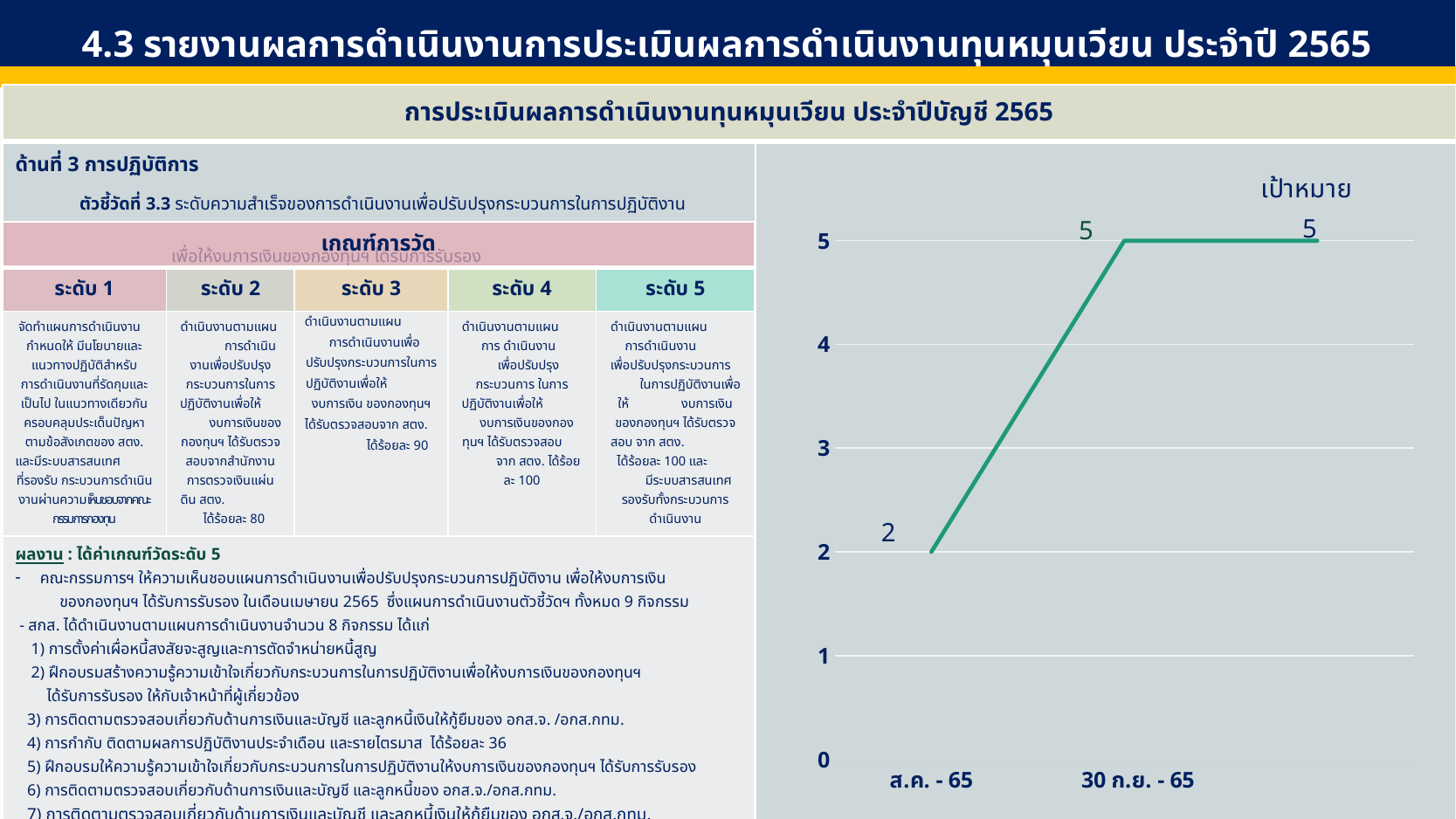
What value is plotted for 30 ก.ย. - 65 on the line chart? 5 Is the value for ส.ค. - 65 greater or less than 3? less What is the highest value plotted on the line chart? 5 What is the highest tick value shown on the y axis of the line chart? 5 What value is shown for เป้าหมาย (the target) on the line chart? 5 How many data points are plotted on the line chart? 3 Does the line rise or fall from ส.ค. - 65 to 30 ก.ย. - 65? rise What kind of chart is shown on the right side of the slide? line chart Which has the larger value, ส.ค. - 65 or 30 ก.ย. - 65? 30 ก.ย. - 65 By how much does the value at 30 ก.ย. - 65 exceed the value at ส.ค. - 65? 3 Which labelled point on the line chart has the lowest value? ส.ค. - 65 What value is plotted for ส.ค. - 65 on the line chart? 2